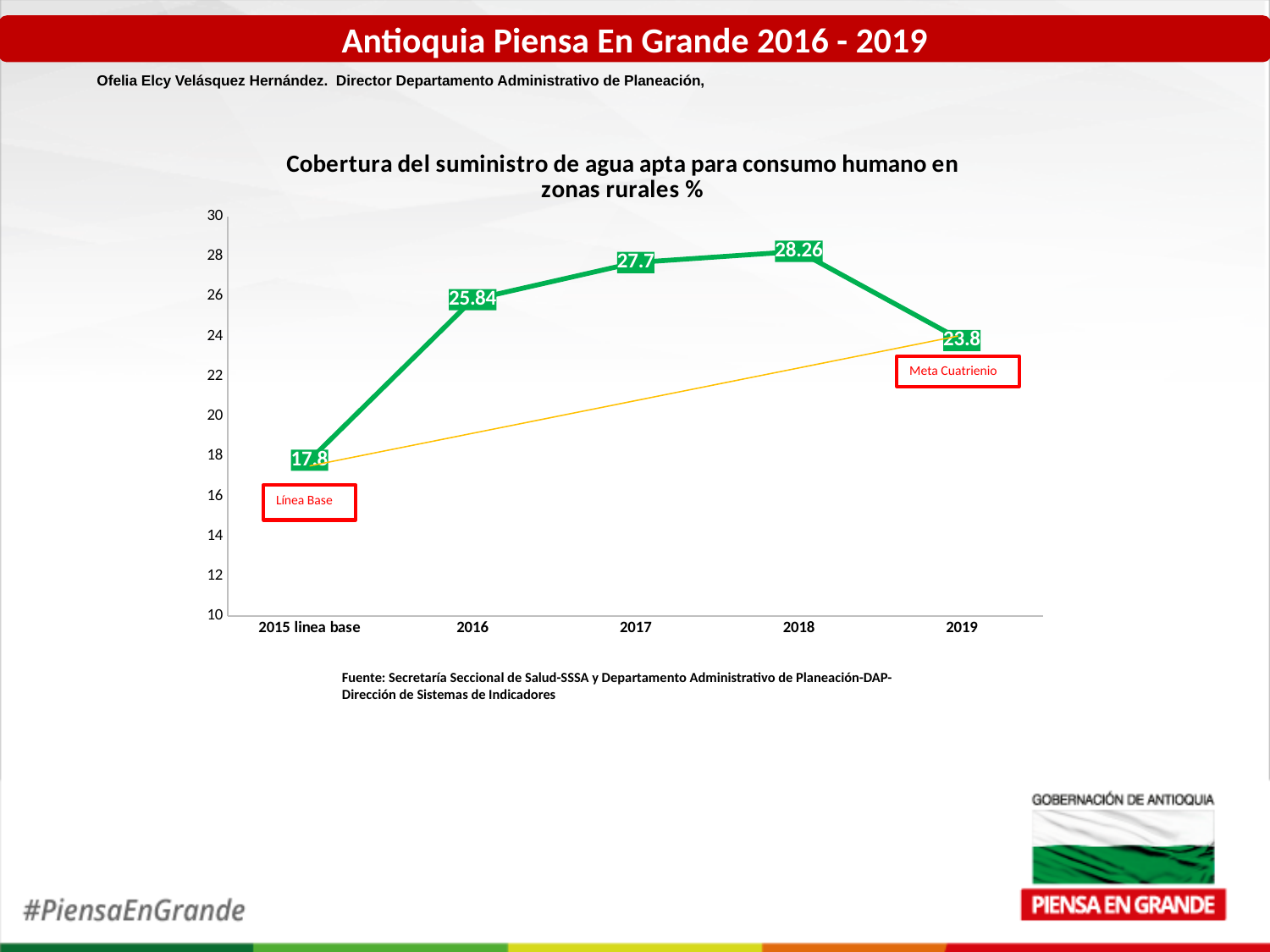
What is the difference between the values for 2018 and 2019? 4.46 What is the title of the chart? Cobertura del suministro de agua apta para consumo humano en zonas rurales % How many categories are shown on the x axis? 5 Which category has the lowest value? 2015 linea base What kind of chart is this? Line chart What is the value for 2016? 25.84 What is the value for 2015 linea base? 17.8 Which is larger, the value for 2017 or the value for 2019? 2017 What is the value for 2018? 28.26 What is the value for 2019? 23.8 Do the values rise or fall from 2015 linea base to 2018? Rise Which year has the highest value? 2018